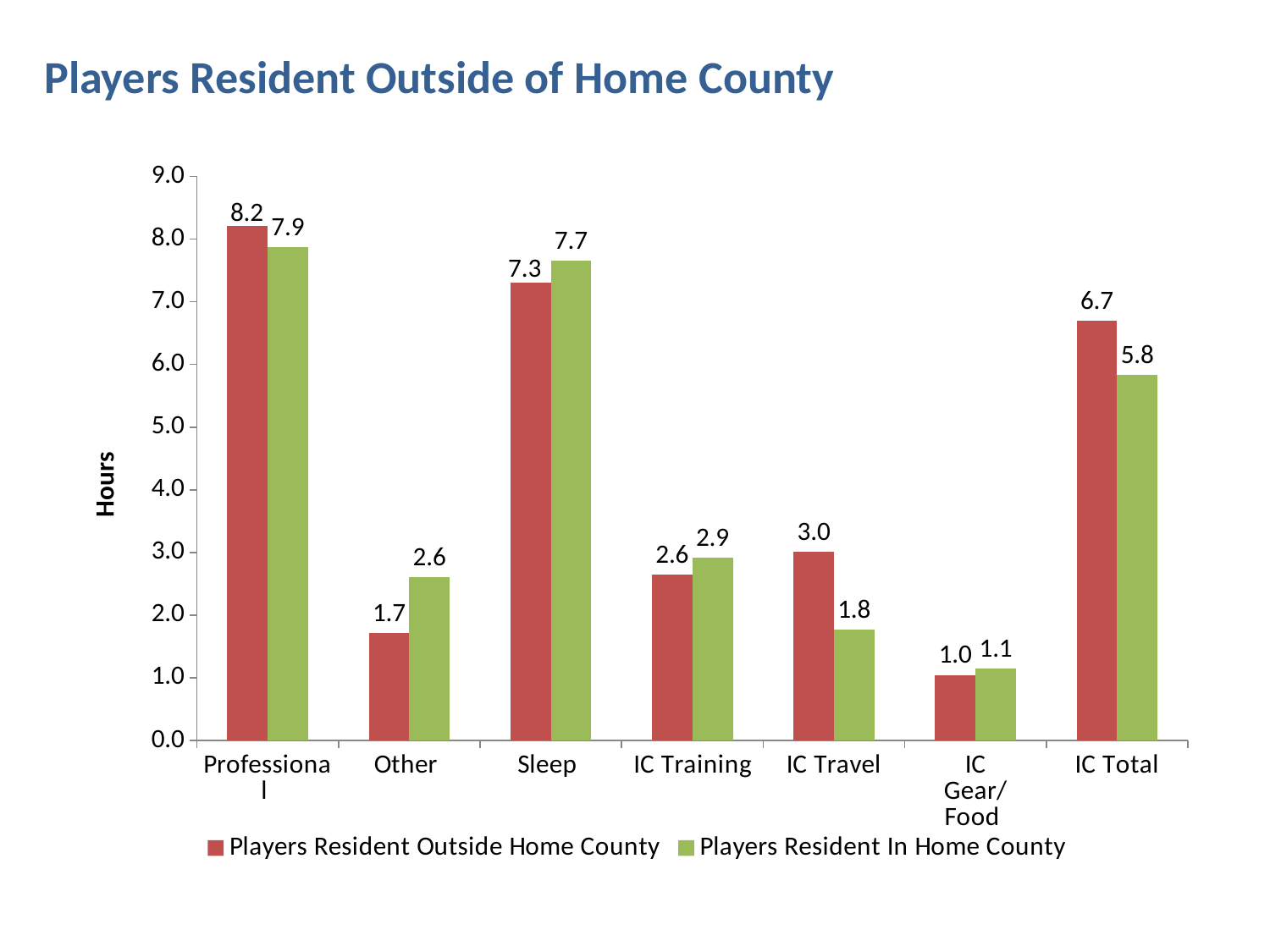
How many series does the legend list? 2 What is the value for IC Travel for Players Resident In Home County? 1.8 For IC Training, which series has the larger value? Players Resident In Home County Which category has the highest value for Players Resident Outside Home County? Professional What is the difference between the two series for Other? 0.9 What kind of chart is shown on the slide? Bar chart What is the value for IC Total for Players Resident Outside Home County? 6.7 What is the label of the vertical axis? Hours Which category has the lowest value for Players Resident In Home County? IC Gear/Food How many categories are shown on the x axis? 7 What is the difference between the two series for IC Travel? 1.2 What is the value for Sleep for Players Resident Outside Home County? 7.3